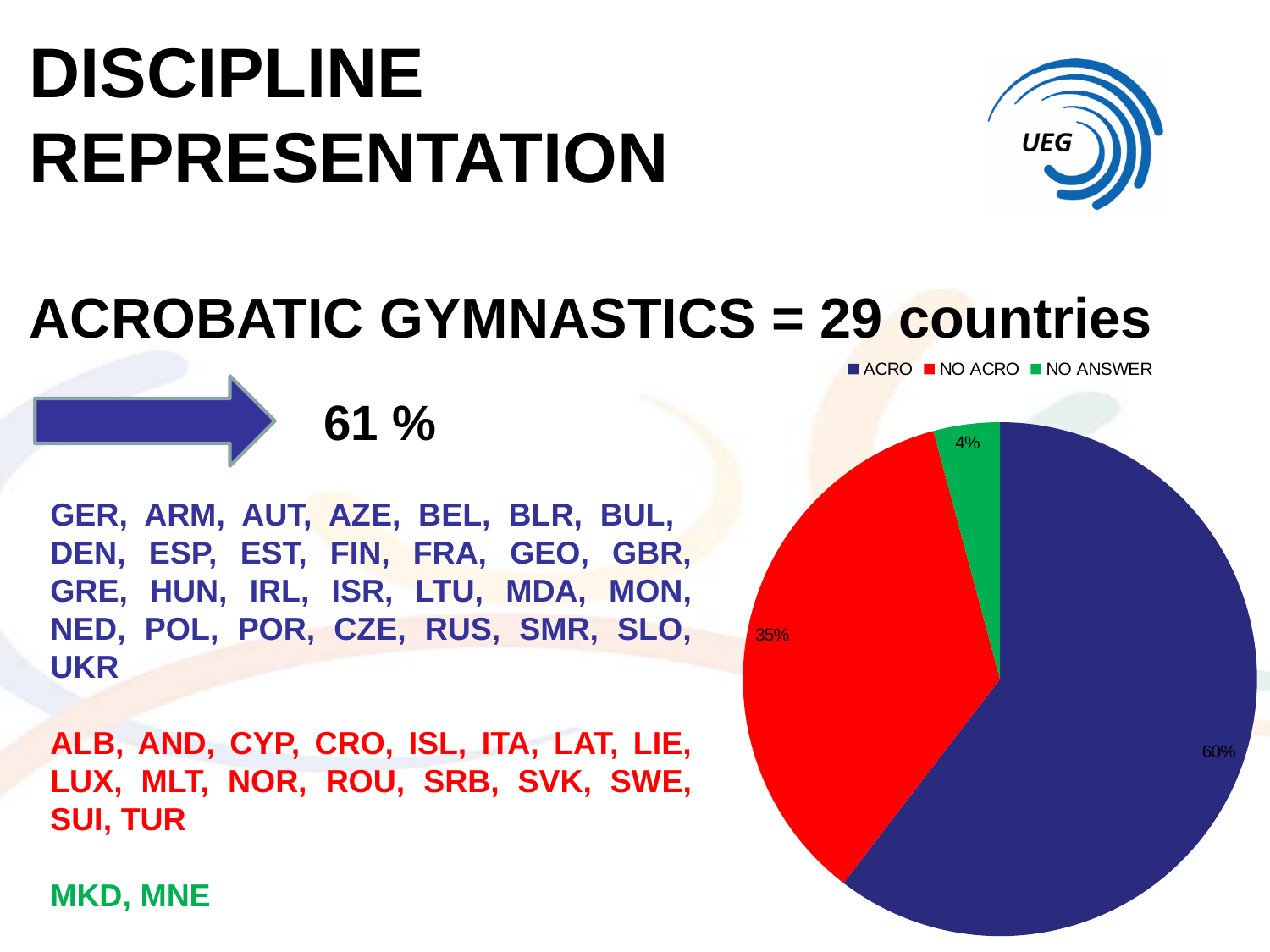
How many slices does the pie chart have? 3 What colour is the NO ANSWER slice? green What share of the pie does NO ANSWER represent? 4% Which slice of the pie is the largest? ACRO Which slice of the pie is the smallest? NO ANSWER What is the difference in percentage points between the ACRO and NO ACRO slices? 25 What share of the pie does NO ACRO represent? 35% What kind of chart is shown on the slide? pie chart What colour is the NO ACRO slice? red How many entries does the legend list? 3 Which is larger, the NO ACRO slice or the NO ANSWER slice? NO ACRO What share of the pie does ACRO represent? 60%